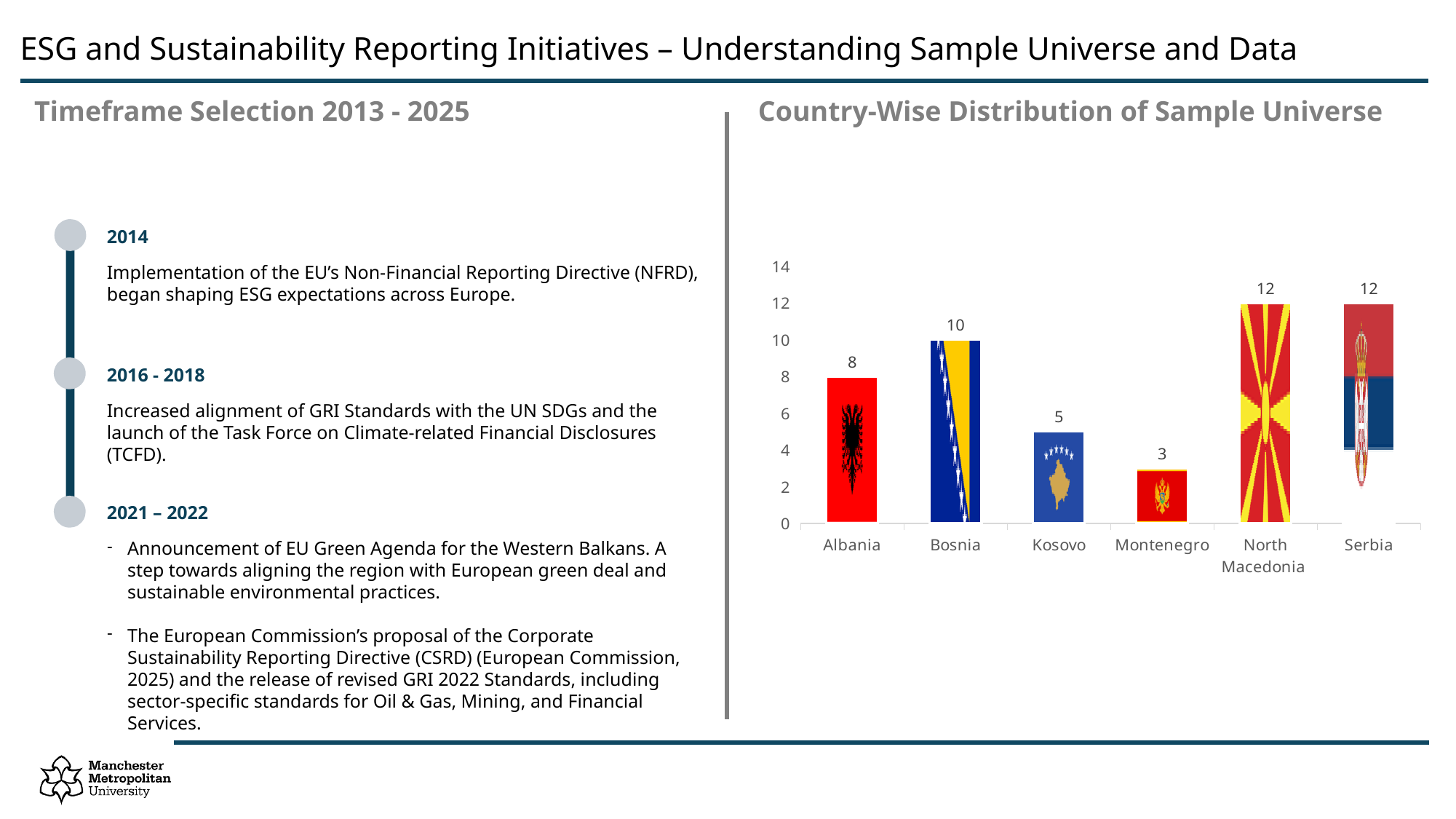
How many countries are shown in the Country-Wise Distribution of Sample Universe chart? 6 Which has a larger value in the Country-Wise Distribution of Sample Universe chart, Albania or Kosovo? Albania What is the difference between the values for Bosnia and Kosovo in the Country-Wise Distribution of Sample Universe chart? 5 What is the total of all values shown in the Country-Wise Distribution of Sample Universe chart? 50 What is the value for Albania in the Country-Wise Distribution of Sample Universe chart? 8 What is the maximum value shown on the vertical axis of the Country-Wise Distribution of Sample Universe chart? 14 What is the value for Bosnia in the Country-Wise Distribution of Sample Universe chart? 10 What type of chart is the Country-Wise Distribution of Sample Universe? Bar chart What is the value for Montenegro in the Country-Wise Distribution of Sample Universe chart? 3 What is the value for Kosovo in the Country-Wise Distribution of Sample Universe chart? 5 Which country has the lowest value in the Country-Wise Distribution of Sample Universe chart? Montenegro Which countries share the highest value in the Country-Wise Distribution of Sample Universe chart? North Macedonia and Serbia